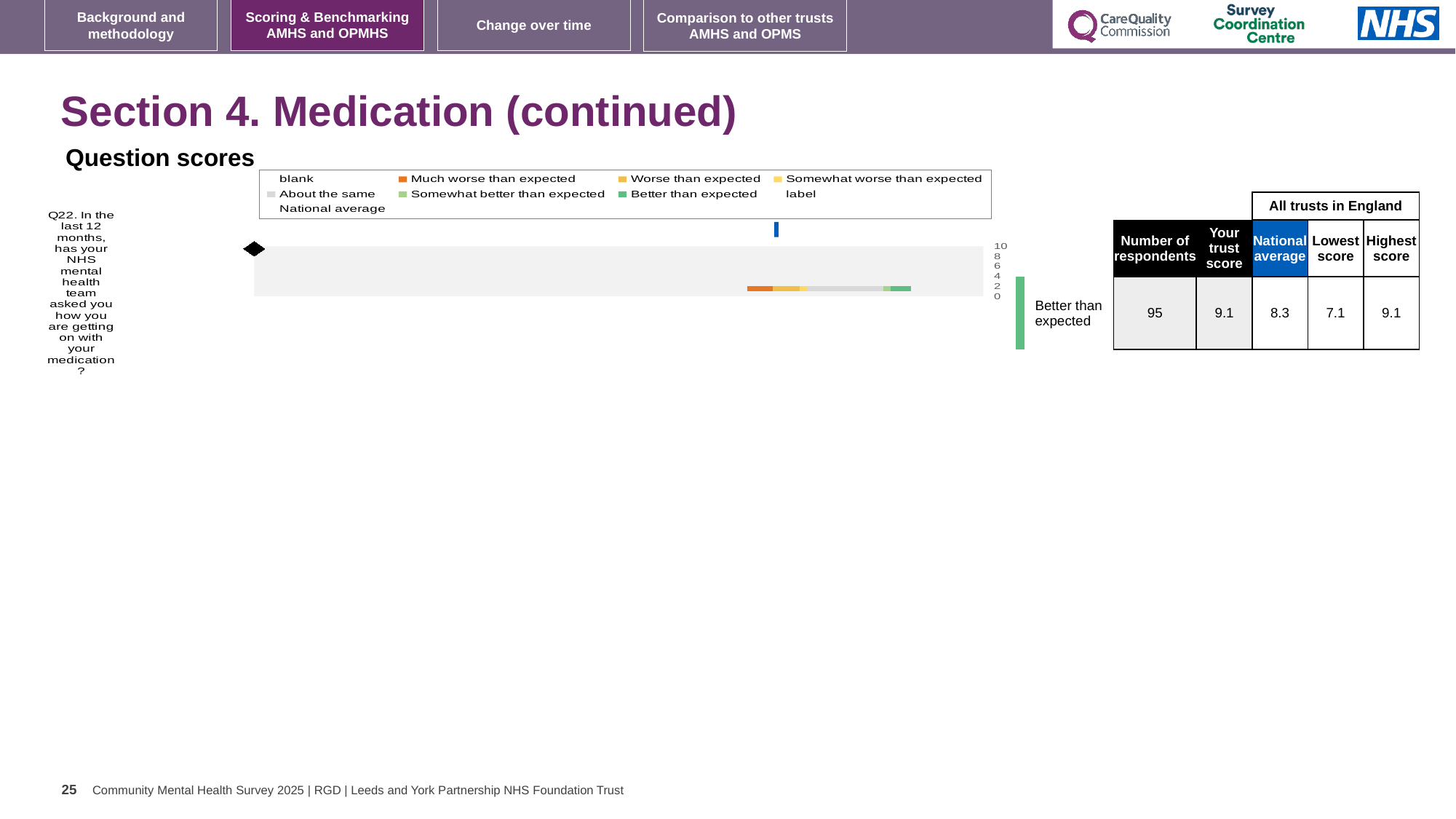
How many entries does the legend of the Question scores chart list? 9 What is the highest tick value shown on the axis of the Question scores chart? 10 In the table next to the chart, what is the national average for Q22? 8.3 In the table next to the chart, what is the number of respondents for Q22? 95 Which question is plotted in the Question scores chart? Q22. In the last 12 months, has your NHS mental health team asked you how you are getting on with your medication? What kind of chart is shown under 'Question scores'? bar chart What colour is the 'Much worse than expected' legend entry in the Question scores chart? orange In the table next to the chart, what is the difference between the highest score and the lowest score for Q22? 2.0 How many questions (categories) are plotted in the Question scores chart? 1 In the table next to the chart, what is your trust score for Q22? 9.1 What benchmark category label is shown to the right of the Q22 bar? Better than expected In the table next to the chart, which is larger for Q22: your trust score or the national average? Your trust score